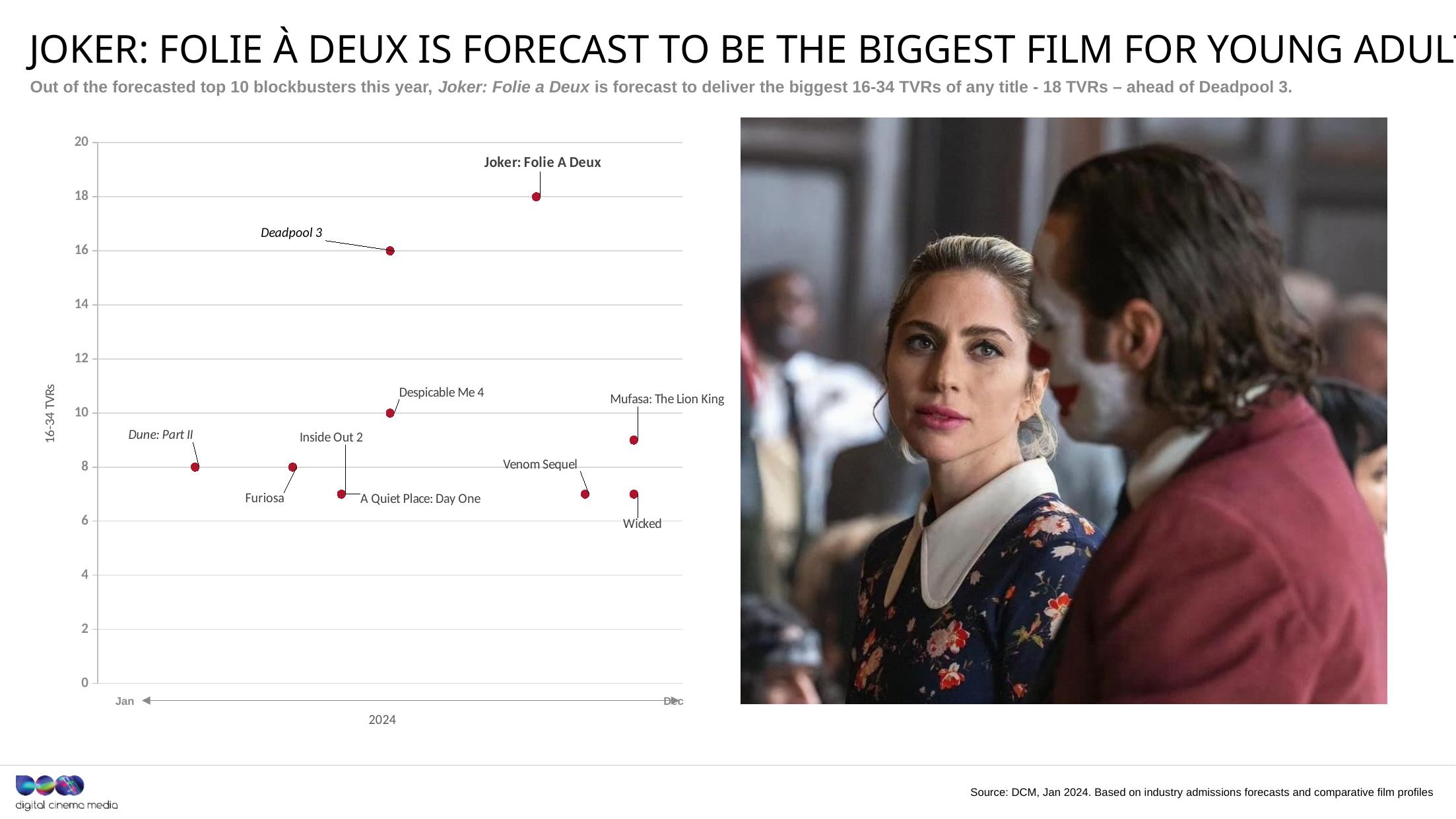
Is the value for Mufasa: The Lion King greater or less than 8? greater Which film has the highest 16-34 TVRs on the chart? Joker: Folie A Deux What is the difference in 16-34 TVRs between Joker: Folie A Deux and Deadpool 3? 2 Is the value for Wicked greater or less than 8? less What is the 16-34 TVRs value for Despicable Me 4? 10 Which year does the horizontal axis of the chart cover? 2024 What is the 16-34 TVRs value for Deadpool 3? 16 What is the label on the vertical axis of the chart? 16-34 TVRs What kind of chart is shown on the slide? scatter chart Which has higher 16-34 TVRs, Deadpool 3 or Despicable Me 4? Deadpool 3 What is the 16-34 TVRs value for Joker: Folie A Deux? 18 What is the 16-34 TVRs value for Dune: Part II? 8